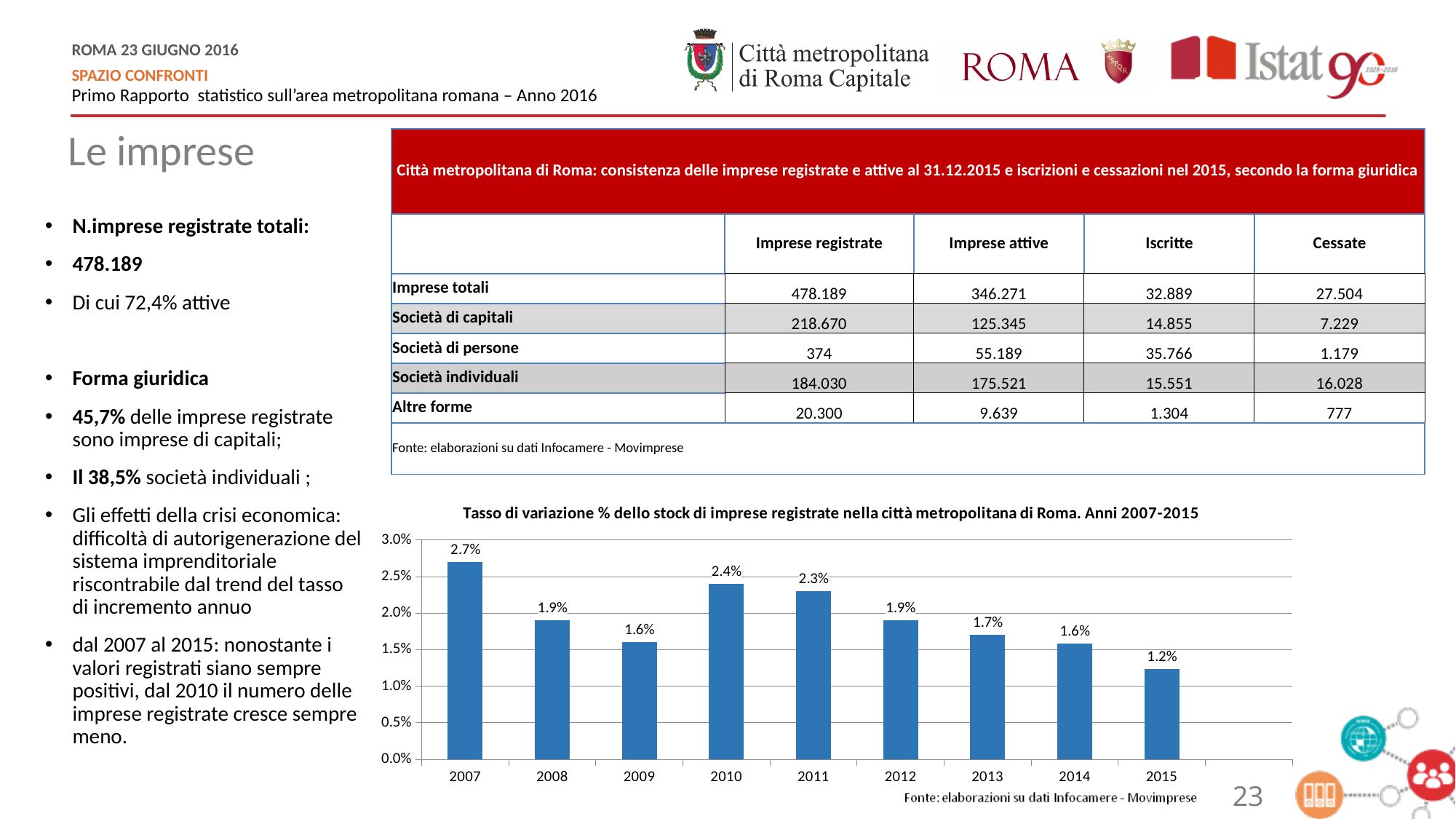
What is the value for 2007 in the bar chart? 2.7% Is the value for 2013 in the bar chart greater or less than 2.0%? less What type of chart is shown at the bottom of the slide? Bar chart What is the value for 2015 in the bar chart? 1.2% What is the title of the bar chart? Tasso di variazione % dello stock di imprese registrate nella città metropolitana di Roma. Anni 2007-2015 Does the value in the bar chart rise or fall from 2010 to 2015? fall Which year has the lowest value in the bar chart? 2015 Which is larger in the bar chart, the value for 2010 or the value for 2011? 2010 What is the value for 2010 in the bar chart? 2.4% How many years are shown on the x axis of the bar chart? 9 What is the difference between the values for 2007 and 2015 in the bar chart? 1.5% Which year has the highest value in the bar chart? 2007